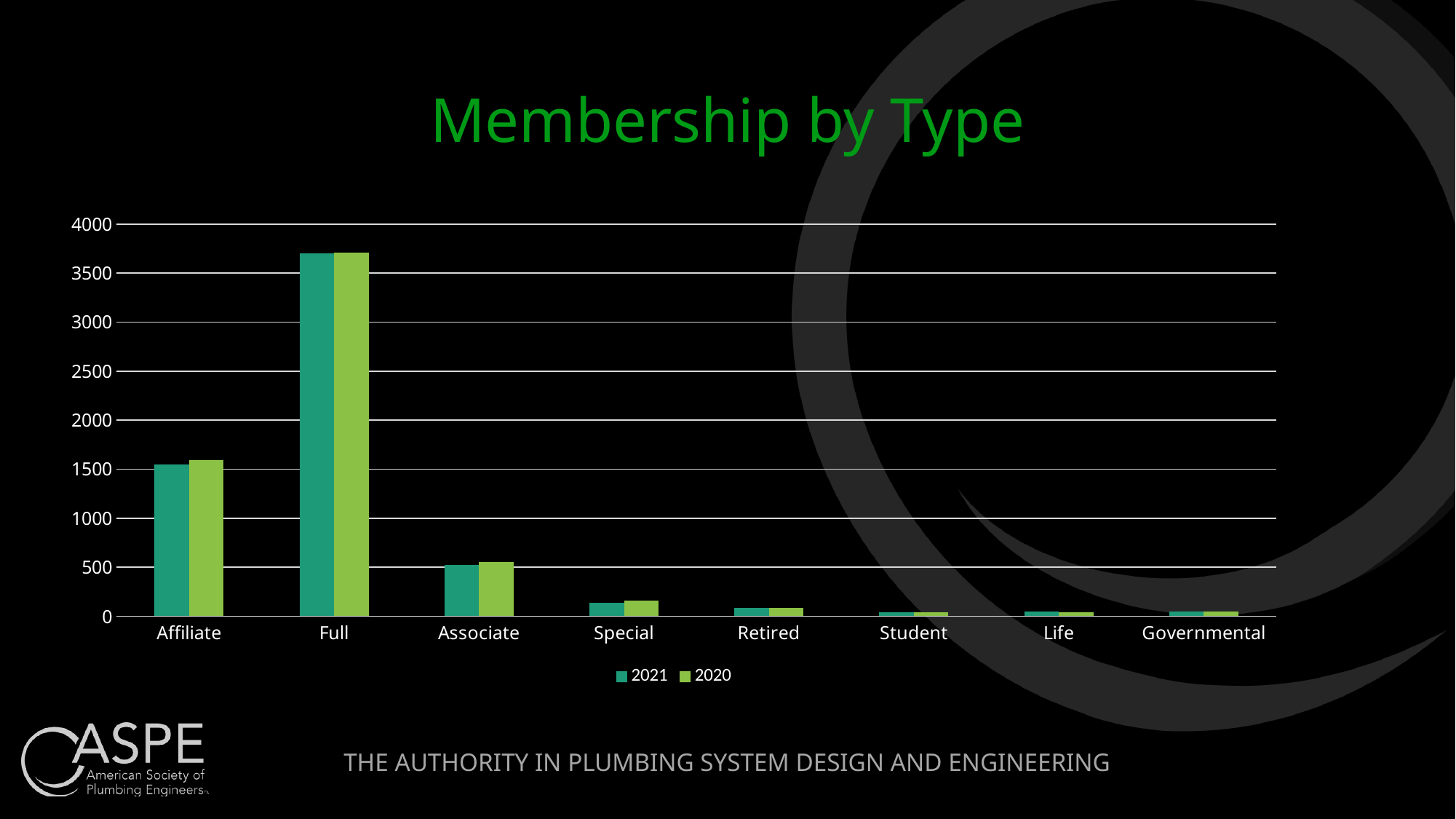
Which is larger in 2021, the value for Affiliate or the value for Associate? Affiliate Which membership type has the highest value in 2021? Full How many membership types are shown on the x axis? 8 Is the 2021 value for Special greater or less than 500? less Which years are listed in the legend? 2021 and 2020 How many series does the legend list? 2 Is the 2021 value for Full greater or less than 3500? greater What kind of chart is shown on the slide? bar chart Which membership type has the highest value in 2020? Full What is the title of the chart? Membership by Type Is the 2020 value for Associate greater or less than 1000? less